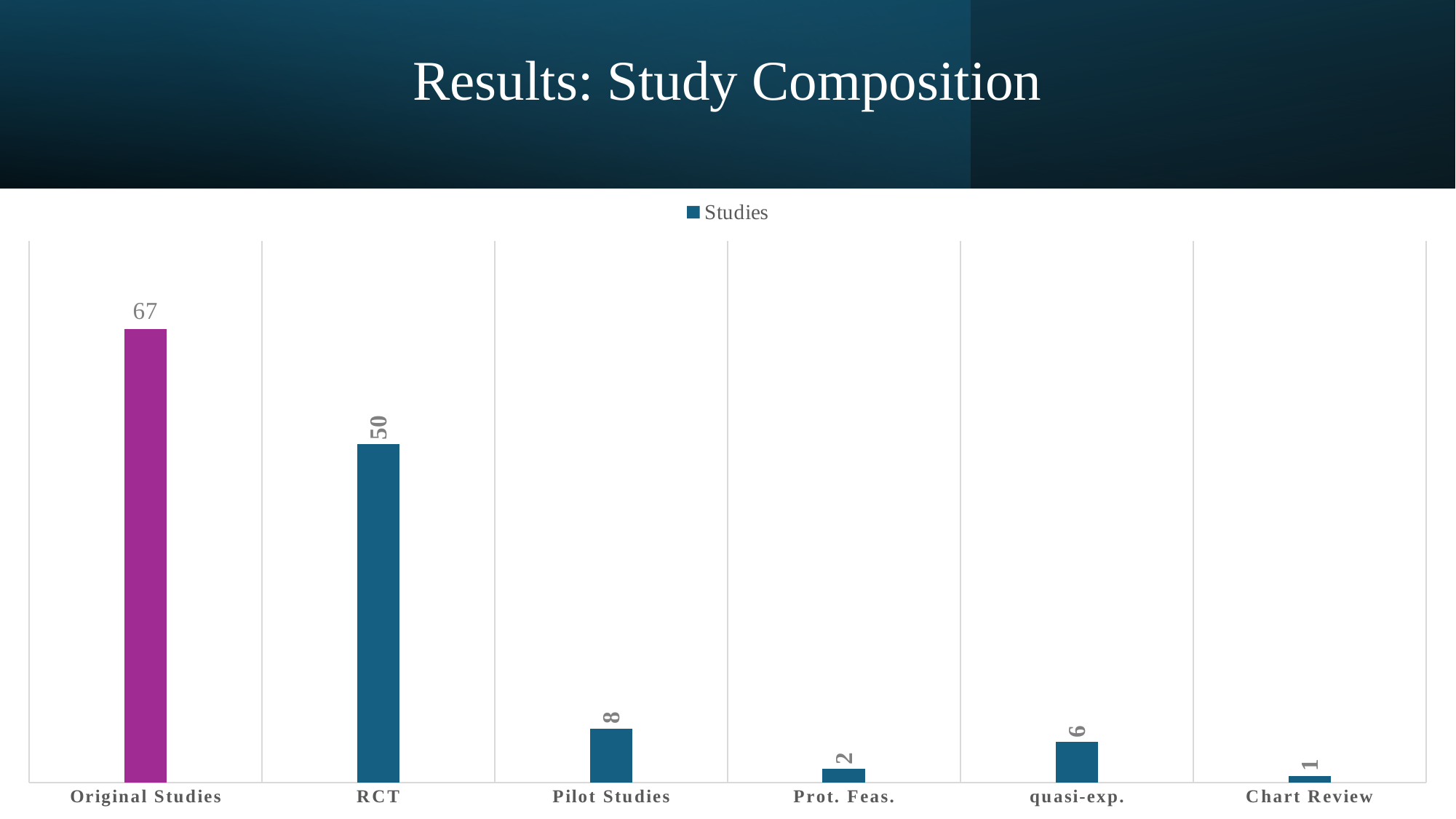
Which category has the highest value? Original Studies How many categories are shown on the x axis? 6 What is the value for RCT? 50 What is the value for Pilot Studies? 8 What is the value for Chart Review? 1 Which category has the lowest value? Chart Review What is the value for Original Studies? 67 How many series does the legend list? 1 Which bar is coloured differently from the others? Original Studies What is the difference between the values for Original Studies and RCT? 17 What kind of chart is shown on the slide? Bar chart Which is larger, the value for Pilot Studies or the value for quasi-exp.? Pilot Studies